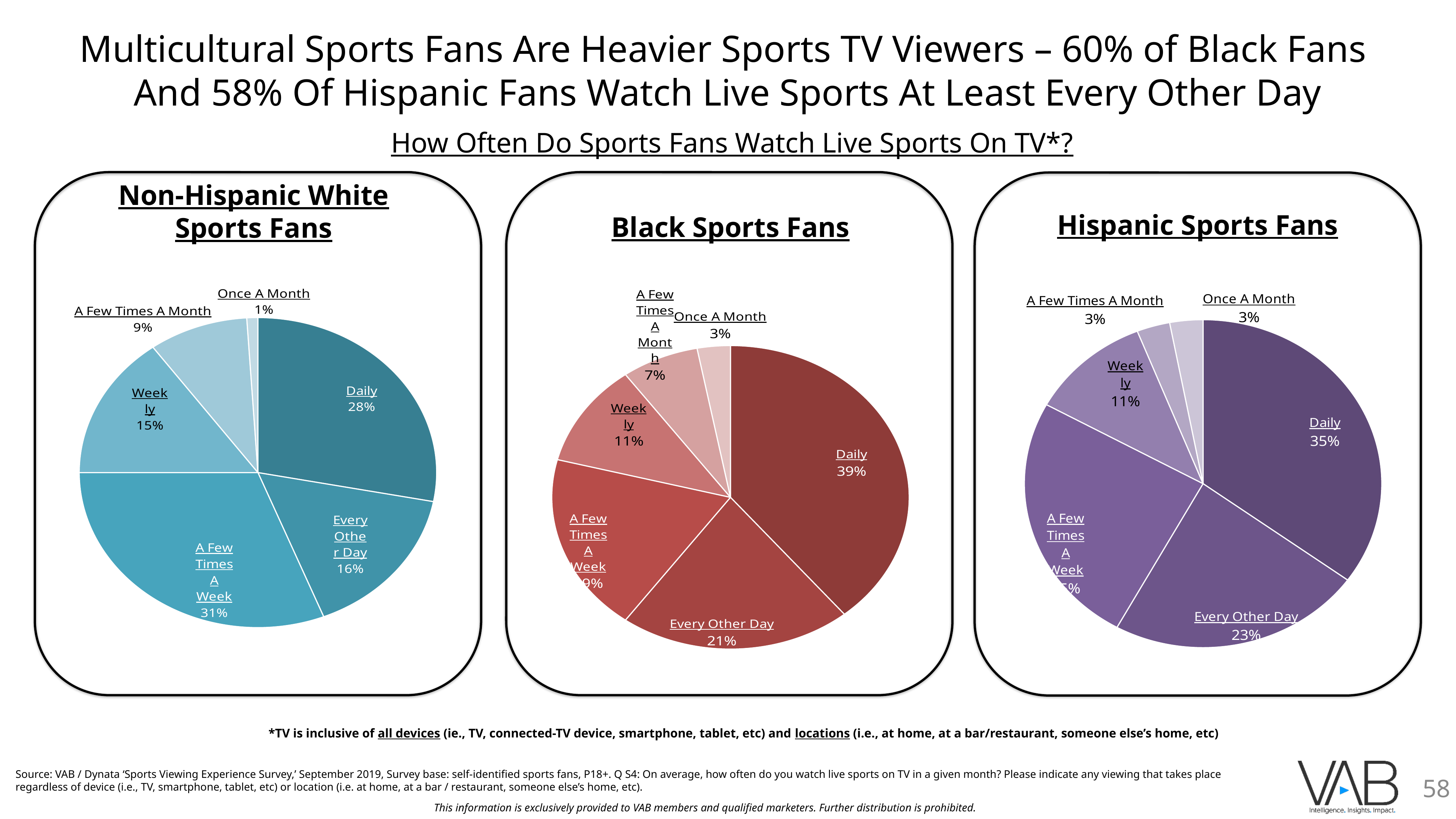
What colour scheme is used for the Hispanic Sports Fans pie chart? Purple In the Black Sports Fans pie chart, what is the share for Weekly? 11% In the Non-Hispanic White Sports Fans pie chart, which category has the smallest share? Once A Month In the Black Sports Fans pie chart, which category has the largest share? Daily In the Hispanic Sports Fans pie chart, what percentage watch live sports on TV every other day? 23% In the Non-Hispanic White Sports Fans pie chart, which category has the largest share? A Few Times A Week What type of chart is used for the Black Sports Fans data? Pie chart How many categories does each pie chart on the slide show? 6 What is the difference between the Daily share in the Black Sports Fans chart and the Daily share in the Hispanic Sports Fans chart? 4 percentage points In the Hispanic Sports Fans pie chart, which is larger: the Daily share or the Every Other Day share? Daily In the Non-Hispanic White Sports Fans pie chart, what share of fans watch live sports on TV daily? 28% In the Black Sports Fans pie chart, what percentage watch live sports on TV daily? 39%